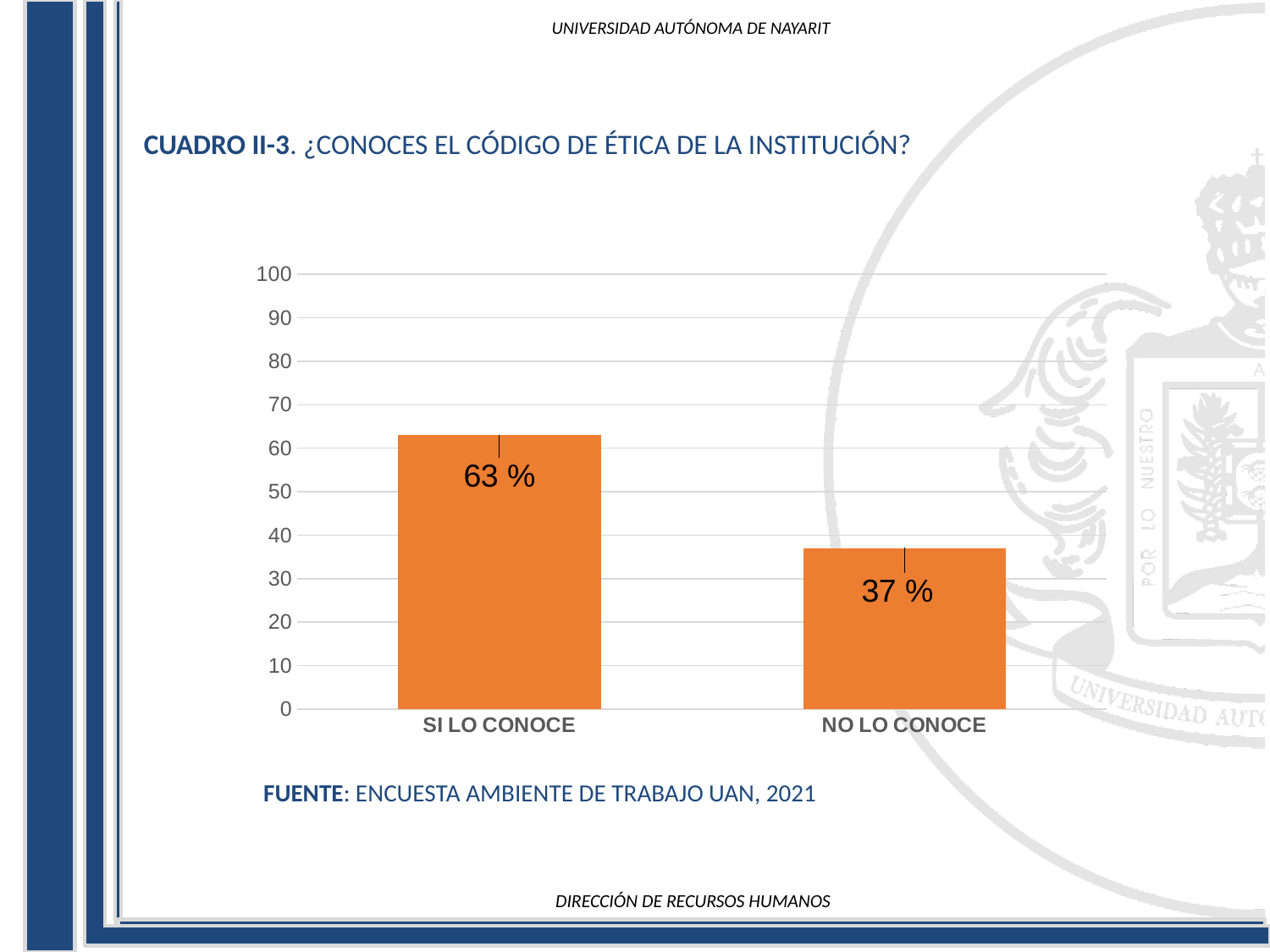
How many categories are shown on the x axis? 2 What is the difference between the values for SI LO CONOCE and NO LO CONOCE? 26 % What is the value for NO LO CONOCE? 37 % Is the value for NO LO CONOCE greater or less than 40? less Is the value for SI LO CONOCE greater or less than 60? greater Which category has the highest value? SI LO CONOCE What kind of chart is shown on the slide? bar chart What is the value for SI LO CONOCE? 63 % Which is larger, the value for SI LO CONOCE or the value for NO LO CONOCE? SI LO CONOCE What is the title of the chart (CUADRO II-3)? ¿CONOCES EL CÓDIGO DE ÉTICA DE LA INSTITUCIÓN? What colour are the bars in the chart? orange Which category has the lowest value? NO LO CONOCE